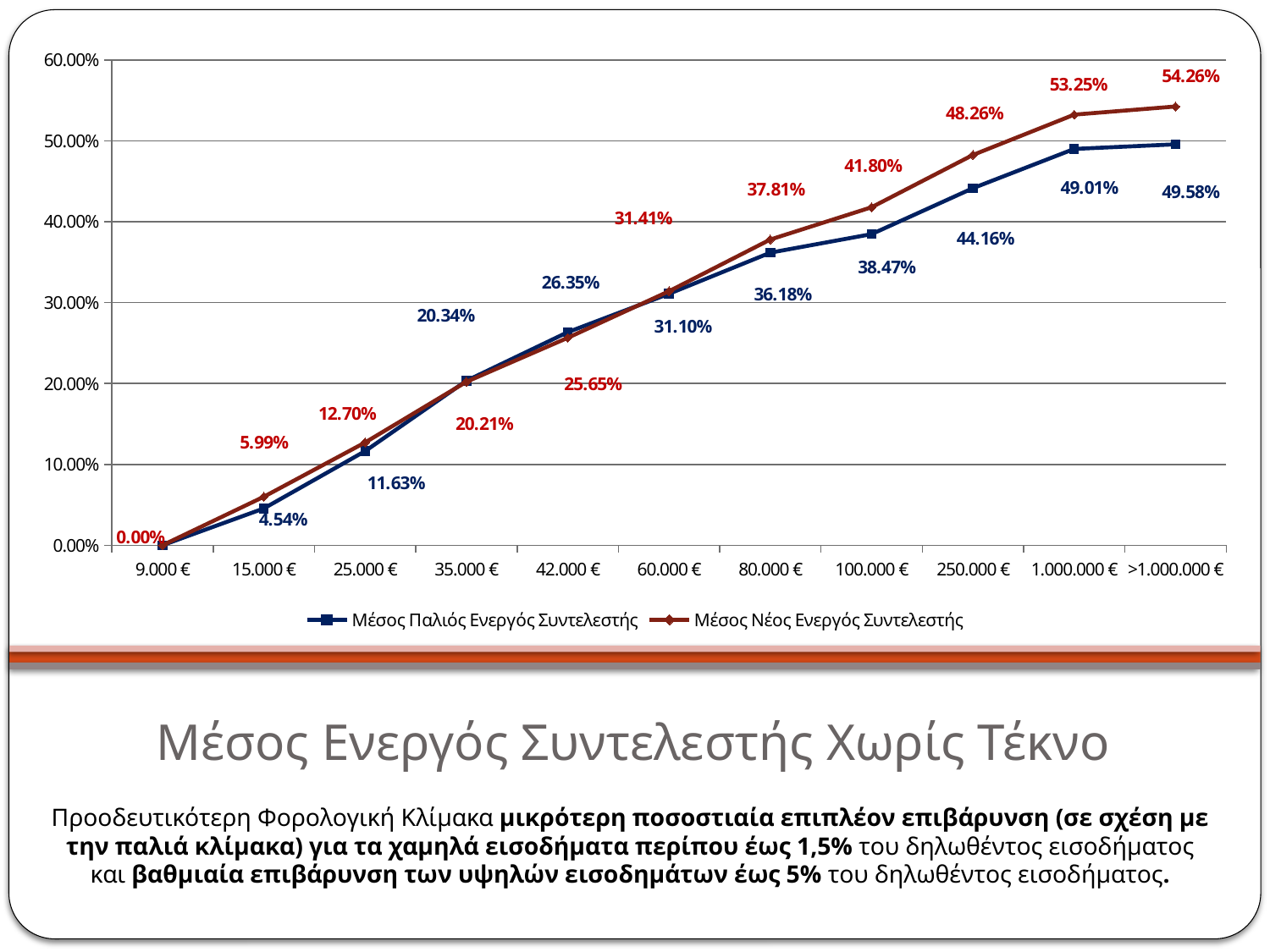
What is the value of the Μέσος Νέος Ενεργός Συντελεστής series at 100.000 €? 41.80% What kind of chart is shown on the slide? Line chart At 80.000 €, which series has the larger value, Μέσος Παλιός Ενεργός Συντελεστής or Μέσος Νέος Ενεργός Συντελεστής? Μέσος Νέος Ενεργός Συντελεστής How many income categories are shown on the x axis? 11 Do the values of the Μέσος Νέος Ενεργός Συντελεστής series rise or fall as income increases along the x axis? Rise At which income category does the Μέσος Νέος Ενεργός Συντελεστής series reach its highest value? >1.000.000 € What is the value of the Μέσος Παλιός Ενεργός Συντελεστής series at >1.000.000 €? 49.58% What is the value of the Μέσος Νέος Ενεργός Συντελεστής series at 15.000 €? 5.99% What is the value of the Μέσος Παλιός Ενεργός Συντελεστής series at 250.000 €? 44.16% What is the difference between the Μέσος Νέος Ενεργός Συντελεστής and Μέσος Παλιός Ενεργός Συντελεστής values at 1.000.000 €? 4.24% How many series does the legend list? 2 At 35.000 €, which series has the larger value, Μέσος Παλιός Ενεργός Συντελεστής or Μέσος Νέος Ενεργός Συντελεστής? Μέσος Παλιός Ενεργός Συντελεστής